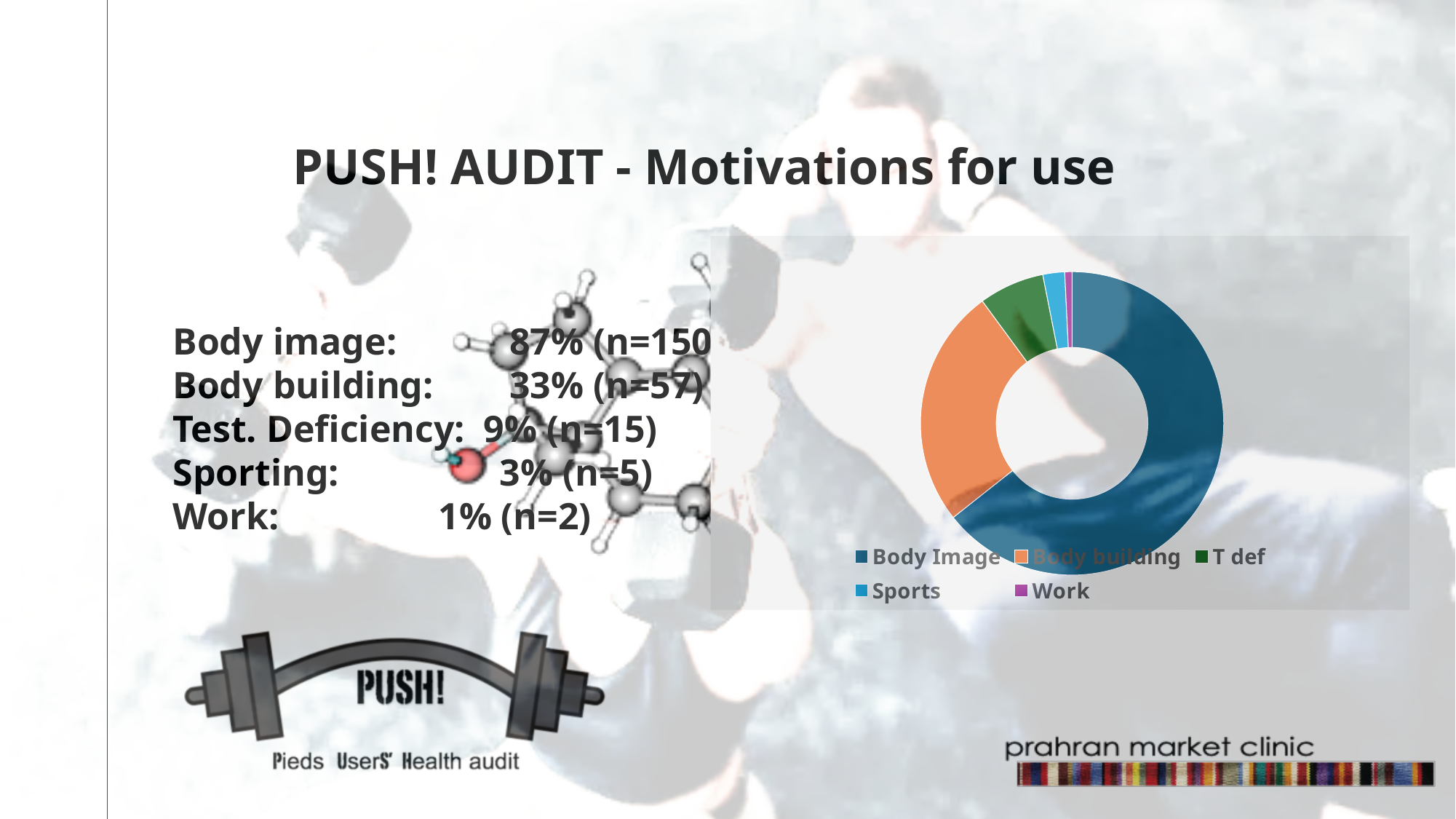
According to the slide text, how many respondents (n) cited work as a motivation? 2 What kind of chart is shown on the slide? doughnut chart What colour is the Body building segment in the doughnut chart? orange What is the title of the slide containing the chart? PUSH! AUDIT - Motivations for use Which category takes up the largest portion of the doughnut chart? Body Image Which is larger in the chart, the Sports segment or the Work segment? Sports Which is larger in the chart, the Body building segment or the T def segment? Body building How many categories does the chart's legend list? 5 According to the slide text, how many respondents (n) cited body building as a motivation? 57 According to the slide text, what percentage cited testosterone deficiency as a motivation? 9% Which category takes up the smallest portion of the doughnut chart? Work According to the slide text, what percentage of respondents cited body image as a motivation? 87%